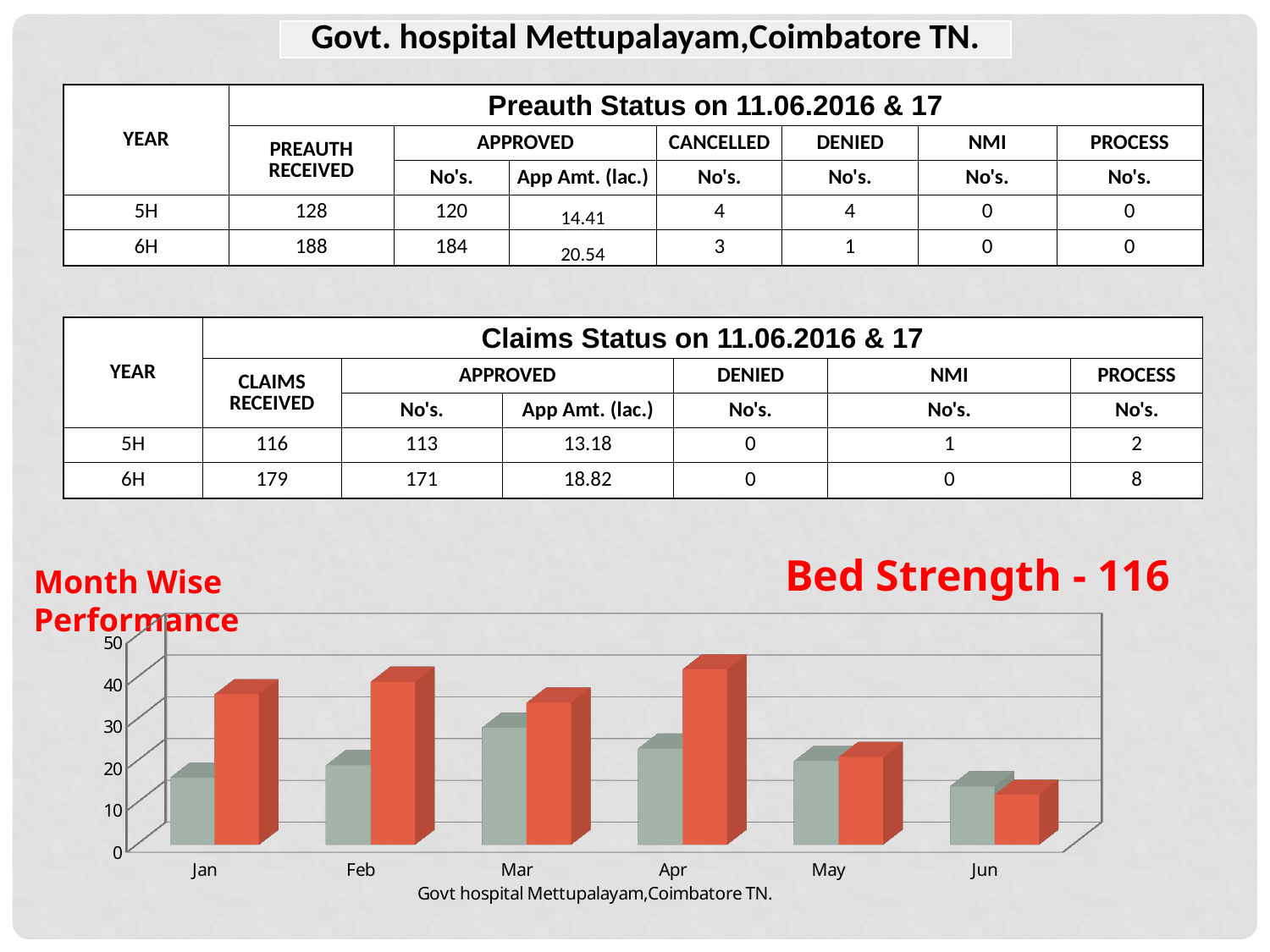
In the Month Wise Performance chart, which month has the shortest red bar? Jun How many bars are plotted for each month in the Month Wise Performance chart? 2 What text appears as the axis title below the months in the Month Wise Performance chart? Govt hospital Mettupalayam,Coimbatore TN. In the Month Wise Performance chart, is the red bar for Jun greater or less than 20? less How many months are shown on the x axis of the Month Wise Performance chart? 6 In the Month Wise Performance chart, do the red bars rise or fall from Apr to Jun? fall In the Month Wise Performance chart, is the red bar for Jan greater or less than 30? greater What kind of chart is shown at the bottom of the slide? bar chart In the Month Wise Performance chart, which is larger for Jan: the grey bar or the red bar? the red bar In the Month Wise Performance chart, which month has the tallest grey bar? Mar In the Month Wise Performance chart, is the grey bar for Feb greater or less than 30? less In the Month Wise Performance chart, which month has the tallest red bar? Apr